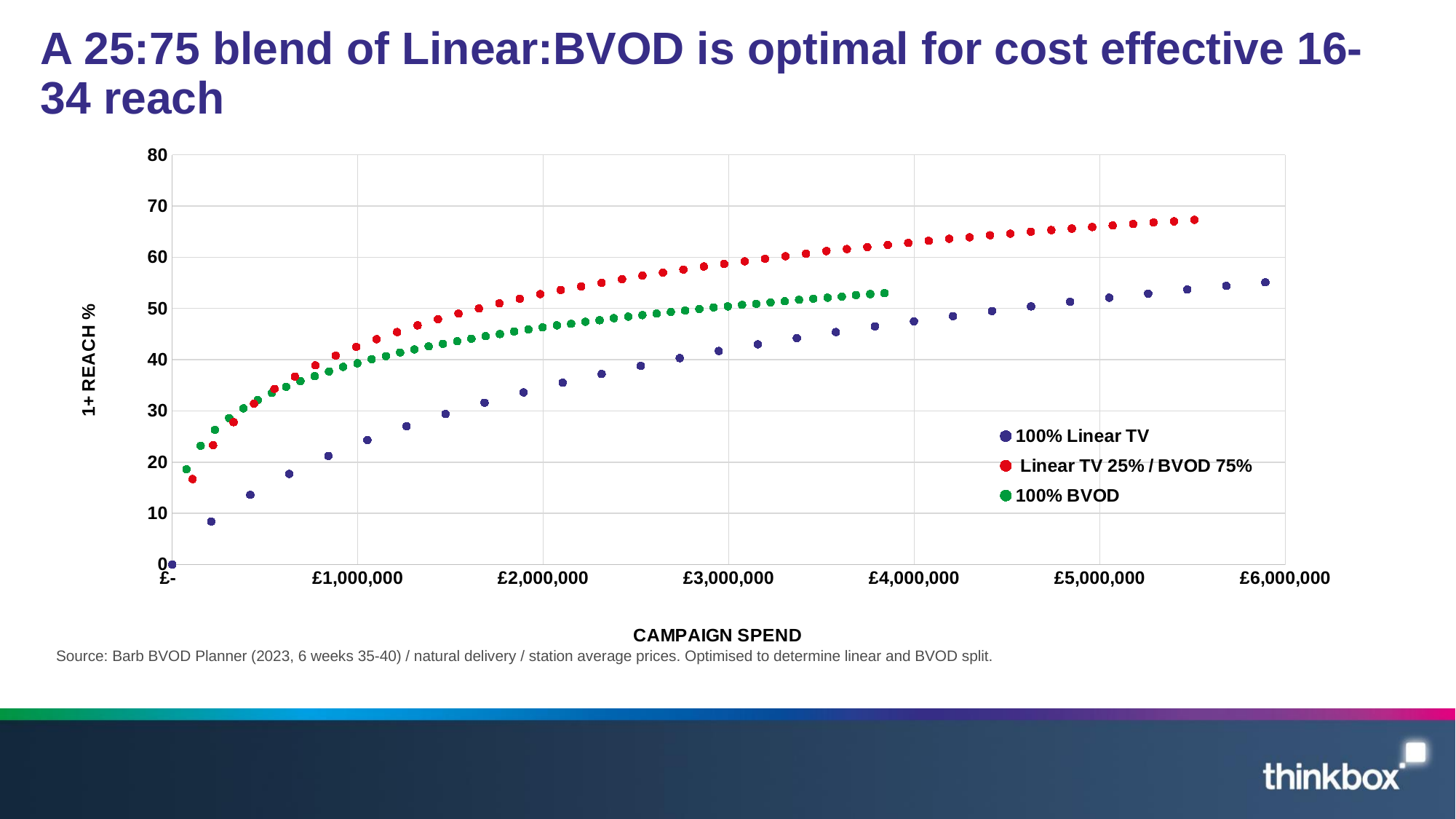
What kind of chart is shown on the slide? Scatter chart How many series does the legend list? 3 Which series reaches the highest 1+ reach % on the chart? Linear TV 25% / BVOD 75% Which series has the lowest 1+ reach % at a campaign spend of £2,000,000? 100% Linear TV Do the 1+ reach % values for 100% Linear TV rise or fall as campaign spend increases? rise Is the 1+ reach % for 100% BVOD at a campaign spend of £2,000,000 greater or less than 40? greater What is the title of the vertical axis? 1+ REACH % What are the three series named in the legend? 100% Linear TV, Linear TV 25% / BVOD 75%, 100% BVOD At a campaign spend of £2,000,000, which series has the higher 1+ reach %: 100% Linear TV or Linear TV 25% / BVOD 75%? Linear TV 25% / BVOD 75% Is the highest 1+ reach % reached by the Linear TV 25% / BVOD 75% series greater or less than 70? less Is the 1+ reach % for 100% Linear TV at a campaign spend of £1,000,000 greater or less than 30? less